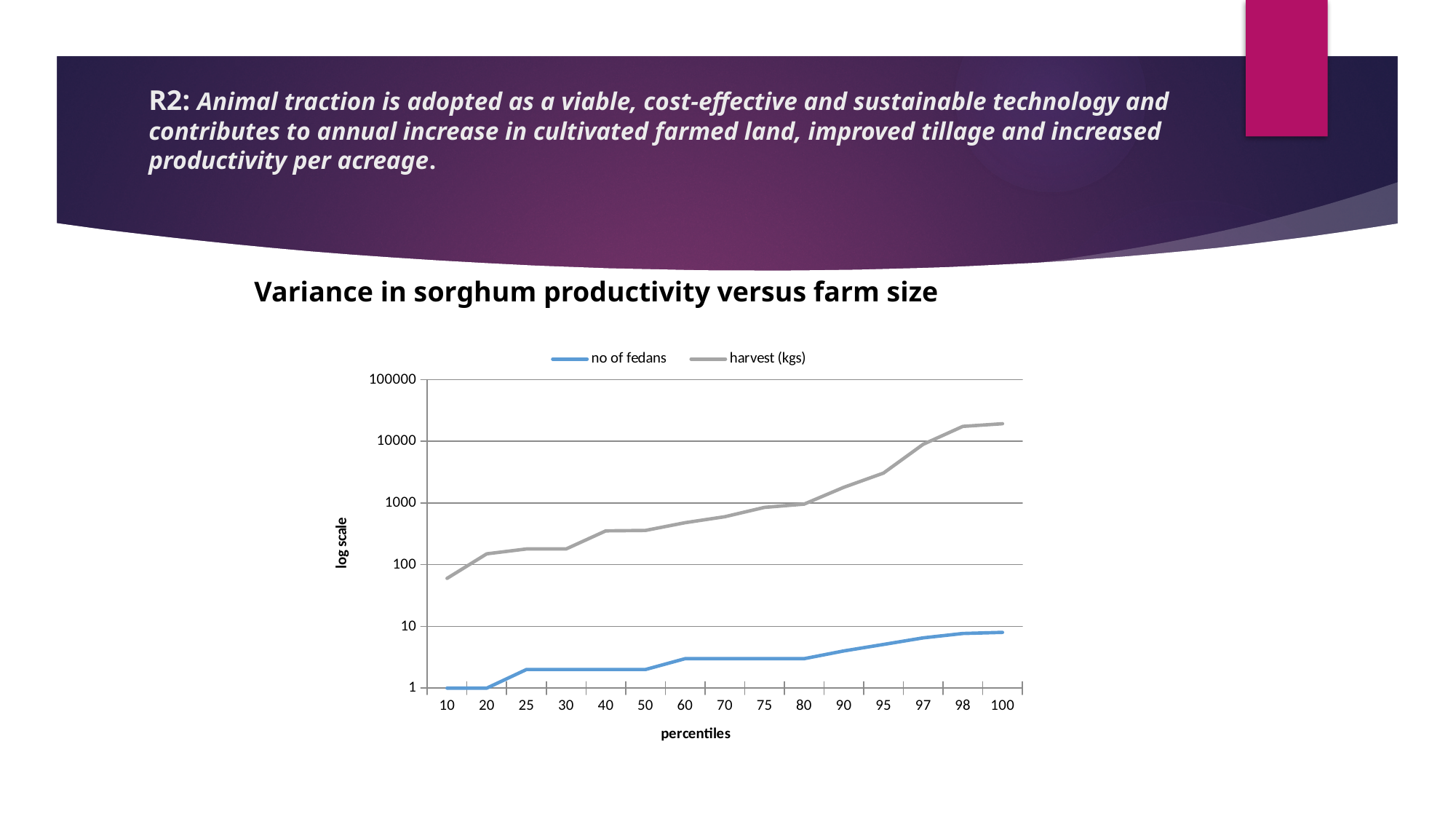
What is the title of the chart? Variance in sorghum productivity versus farm size Is the harvest (kgs) value at the 10th percentile greater or less than 100? less Is the no of fedans value at the 100th percentile greater or less than 10? less Is the harvest (kgs) value at the 95th percentile greater or less than 1000? greater What kind of chart is shown on the slide? line chart Do the harvest (kgs) values rise or fall as the percentiles increase along the x axis? rise How many series does the chart legend list? 2 How many percentile points are plotted along the x axis? 15 At which percentile is the harvest (kgs) value highest? 100 At which percentile is the harvest (kgs) value lowest? 10 What is the label on the y axis of the chart? log scale